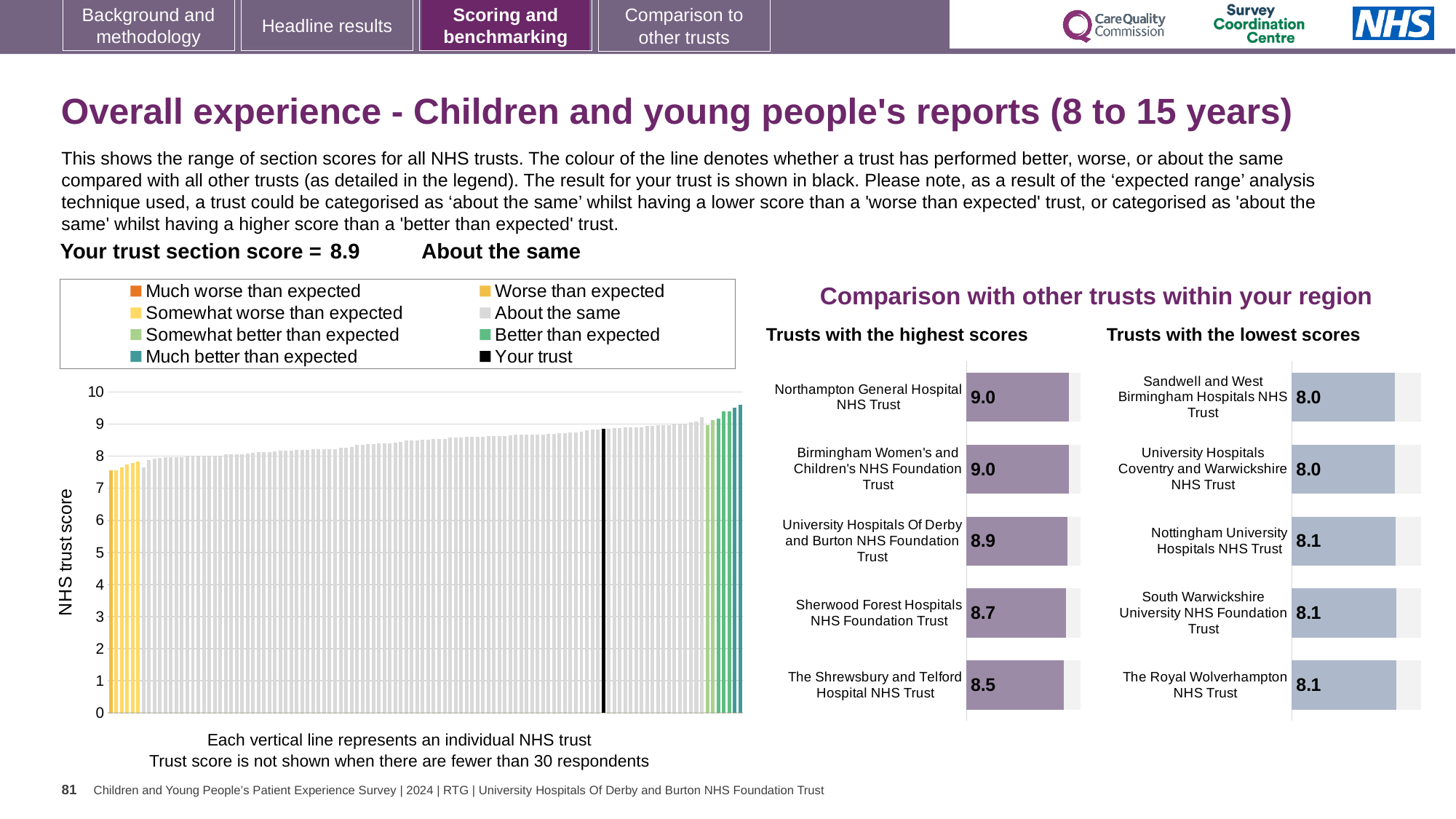
What kind of chart is the 'NHS trust score' chart on the left of the slide? Bar chart How many entries does the legend of the 'NHS trust score' chart on the left list? 8 In the 'Trusts with the highest scores' chart, what is the score for Sherwood Forest Hospitals NHS Foundation Trust? 8.7 In the 'Trusts with the highest scores' chart, what is the score for Northampton General Hospital NHS Trust? 9.0 In the 'NHS trust score' chart on the left, what colour is the bar for 'Your trust'? Black In the 'Trusts with the lowest scores' chart, which has the larger score: Nottingham University Hospitals NHS Trust or Sandwell and West Birmingham Hospitals NHS Trust? Nottingham University Hospitals NHS Trust How many trusts are shown in the 'Trusts with the lowest scores' chart? 5 In the 'Trusts with the highest scores' chart, what is the difference between the scores of Northampton General Hospital NHS Trust and The Shrewsbury and Telford Hospital NHS Trust? 0.5 In the 'Trusts with the highest scores' chart, which trust has the lowest score? The Shrewsbury and Telford Hospital NHS Trust In the 'Trusts with the lowest scores' chart, what is the score for Nottingham University Hospitals NHS Trust? 8.1 In the 'NHS trust score' chart on the left, do the bar values rise or fall from left to right? Rise In the 'NHS trust score' chart on the left, is the value of the tallest bar greater or less than 10? less